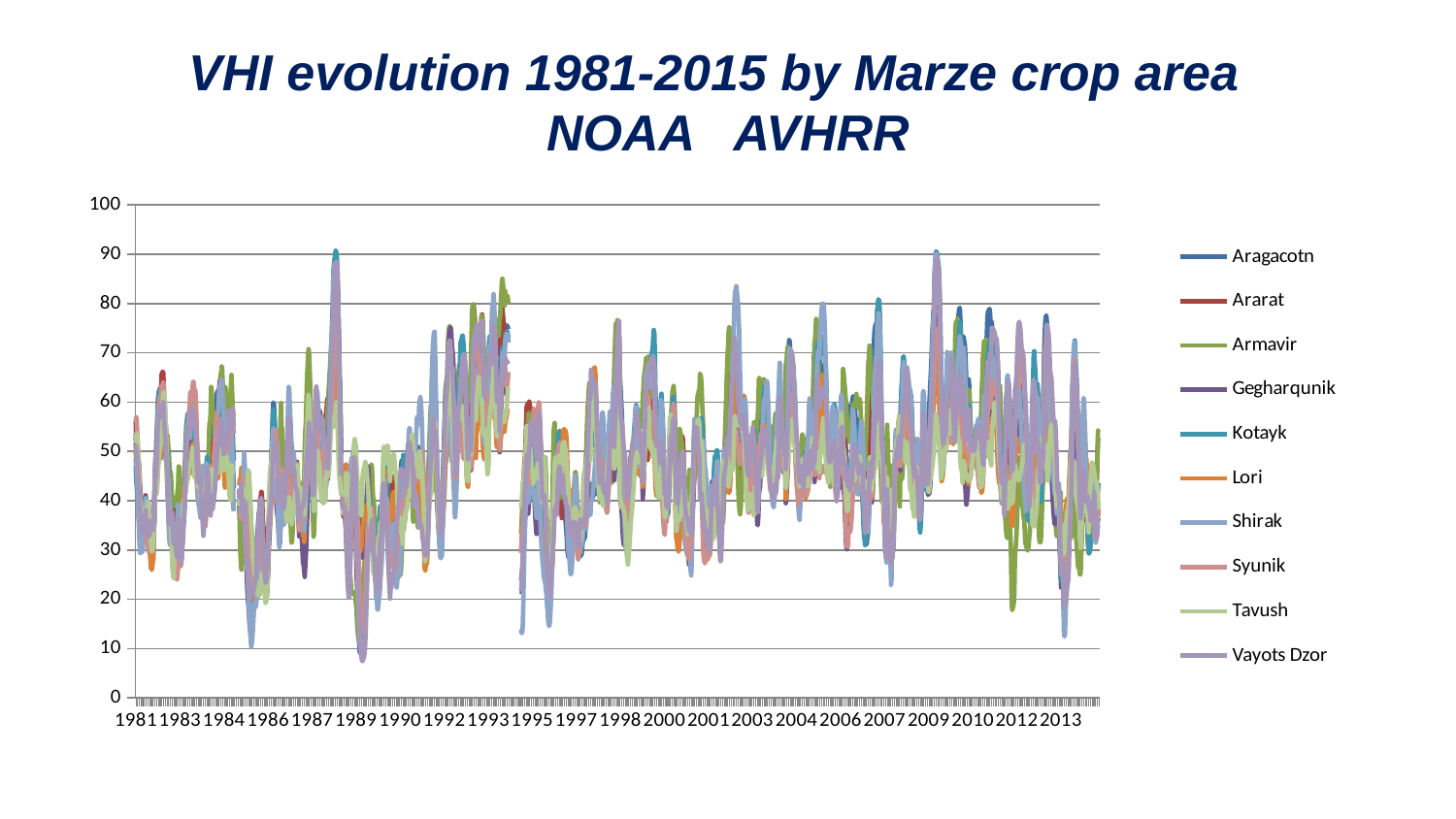
How many series does the legend list? 10 What is the last year labelled on the horizontal axis? 2013 What is the highest value shown on the vertical axis? 100 Is the lowest dip plotted around 1989 greater or less than 20? less Is the highest peak plotted around 1988 greater or less than 80? greater What kind of chart is shown on the slide? line chart What is the first year labelled on the horizontal axis? 1981 Which series is listed last in the legend? Vayots Dzor Which series is listed first in the legend? Aragacotn What is the title of the chart? VHI evolution 1981-2015 by Marze crop area NOAA AVHRR